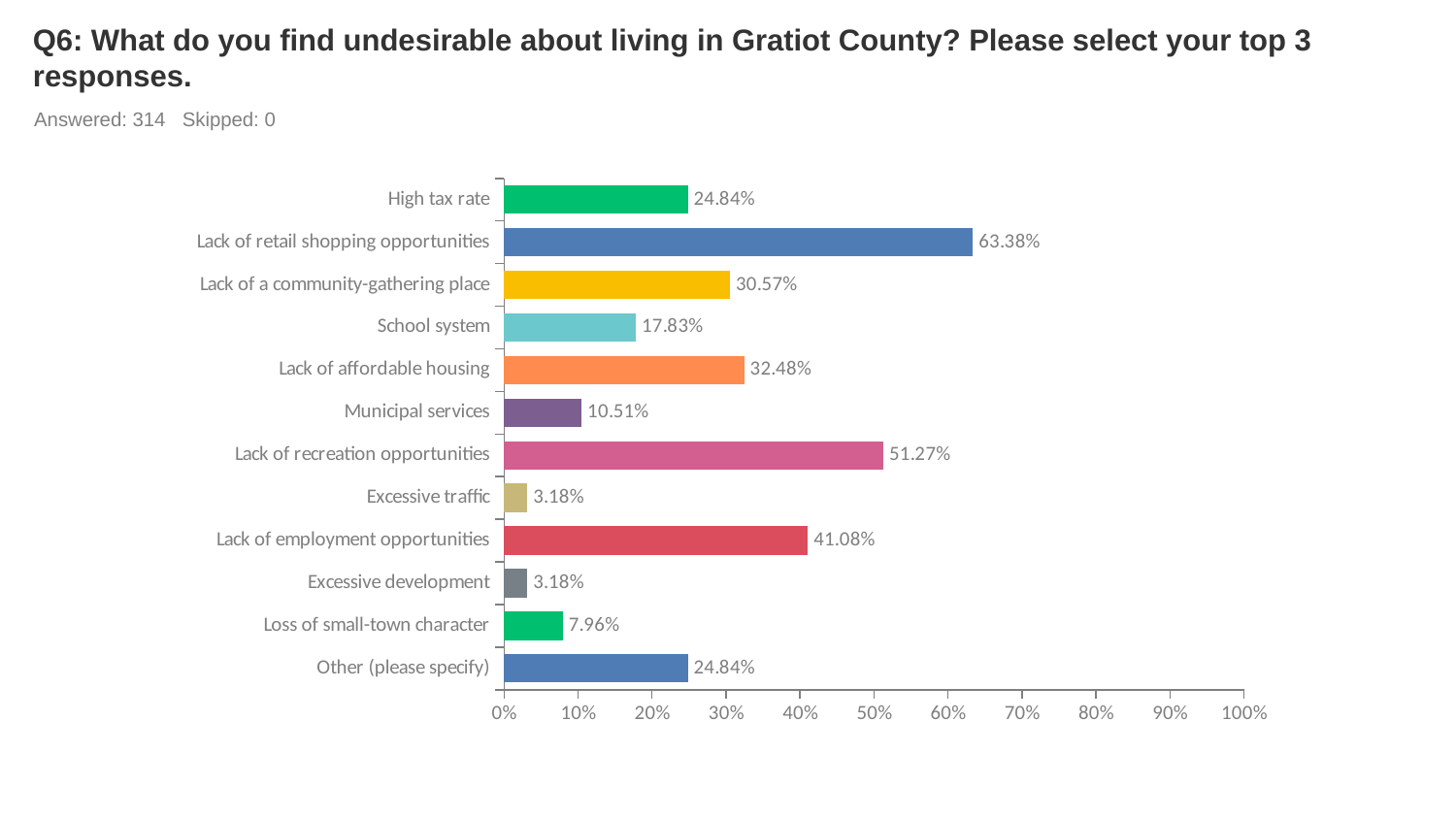
Which category has the lowest value, "Excessive traffic" or "Loss of small-town character"? Excessive traffic What is the difference between "Lack of recreation opportunities" and "Lack of affordable housing"? 18.79% What is the value shown for "Municipal services"? 10.51% Which category has the highest value? Lack of retail shopping opportunities How many categories are shown in the chart? 12 Is the value for "Lack of recreation opportunities" greater or less than 50%? greater What percentage of respondents selected "Lack of retail shopping opportunities"? 63.38% What is the difference between "High tax rate" and "Other (please specify)"? 0% What kind of chart is shown on the slide? Bar chart How many respondents answered this question? 314 What percentage is shown for "Lack of employment opportunities"? 41.08% Which is larger, "Lack of a community-gathering place" or "School system"? Lack of a community-gathering place